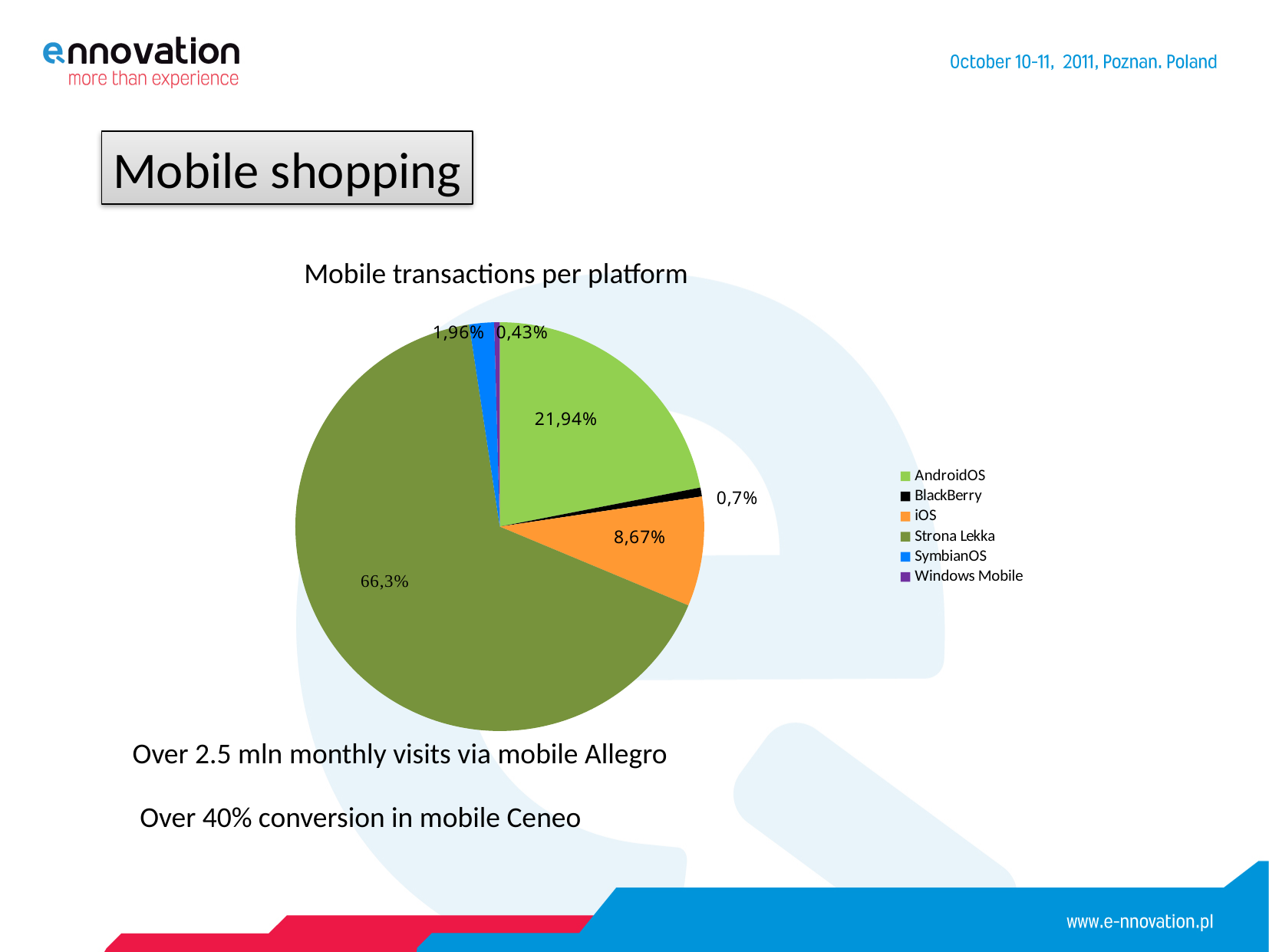
What share of mobile transactions does iOS account for? 8,67% What share of mobile transactions does BlackBerry account for? 0,7% What kind of chart is shown on the slide? Pie chart What share of mobile transactions does Strona Lekka account for? 66,3% What share of mobile transactions does SymbianOS account for? 1,96% What share of mobile transactions does Windows Mobile account for? 0,43% What share of mobile transactions does AndroidOS account for? 21,94% Which has a larger share of mobile transactions, AndroidOS or iOS? AndroidOS Which platform has the smallest share of mobile transactions? Windows Mobile How many platforms are listed in the chart legend? 6 Which platform has the largest share of mobile transactions? Strona Lekka What is the title of the chart? Mobile transactions per platform